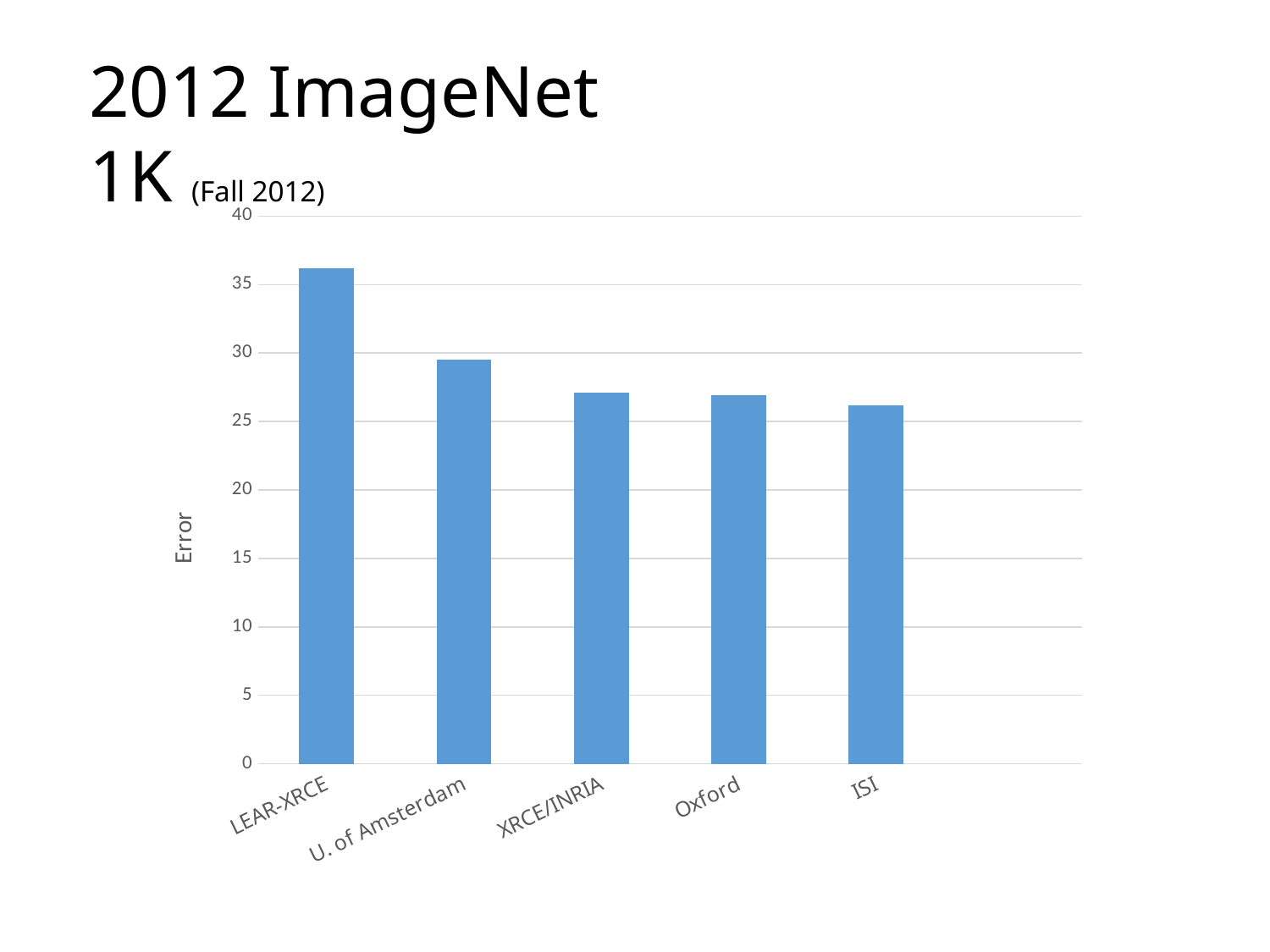
Is the error for Oxford greater or less than 30? less Which has a higher error, U. of Amsterdam or ISI? U. of Amsterdam Is the error for ISI greater or less than 25? greater What kind of chart is shown on the slide? bar chart How many teams (categories) are shown on the x axis of the chart? 5 Which team has the highest error in the chart? LEAR-XRCE Do the error values rise or fall moving from left to right along the x axis? fall Is the error for U. of Amsterdam greater or less than 25? greater What is the label on the vertical axis of the chart? Error Which has a higher error, LEAR-XRCE or U. of Amsterdam? LEAR-XRCE